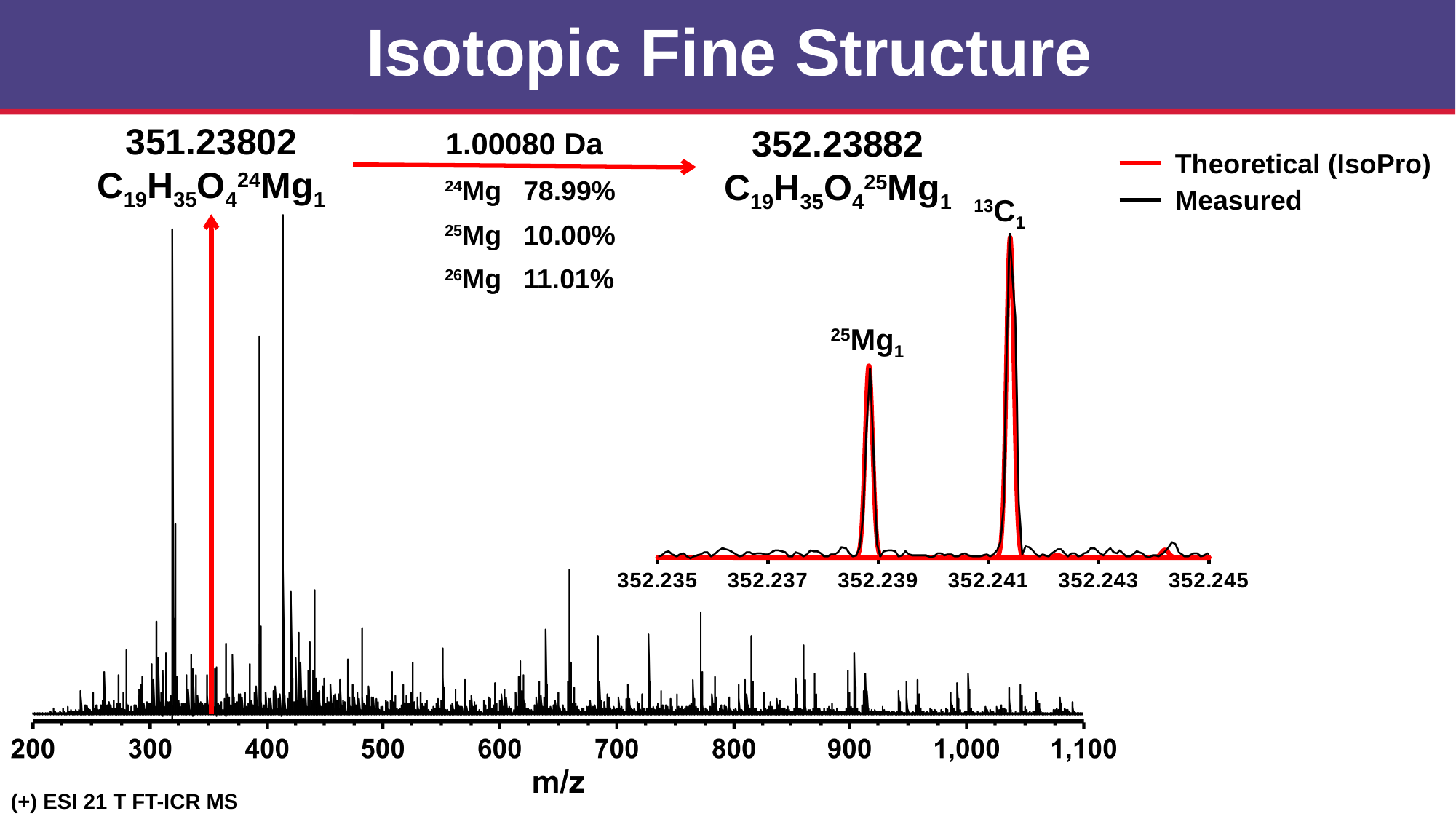
What m/z value is given for C19H35O4 24Mg1? 351.23802 What is the x-axis label of the large mass spectrum at the bottom of the slide? m/z What kind of chart is the inset plot in the upper right (x axis 352.235 to 352.245)? line chart In the inset chart, which labeled peak is taller, 25Mg1 or 13C1? 13C1 In the inset chart, is the 25Mg1 peak located at an m/z greater or less than 352.241? less In the inset chart, is the 13C1 peak located at an m/z greater or less than 352.239? greater What mass difference in Da is shown between C19H35O4 24Mg1 and C19H35O4 25Mg1? 1.00080 Da Which magnesium isotope listed on the slide has the lowest abundance? 25Mg What is the difference between the listed abundances of 26Mg and 25Mg? 1.01% How many series does the legend of the inset chart list? 2 What abundance is listed for 24Mg? 78.99% In the inset chart, what colour is the Theoretical (IsoPro) series drawn in? red